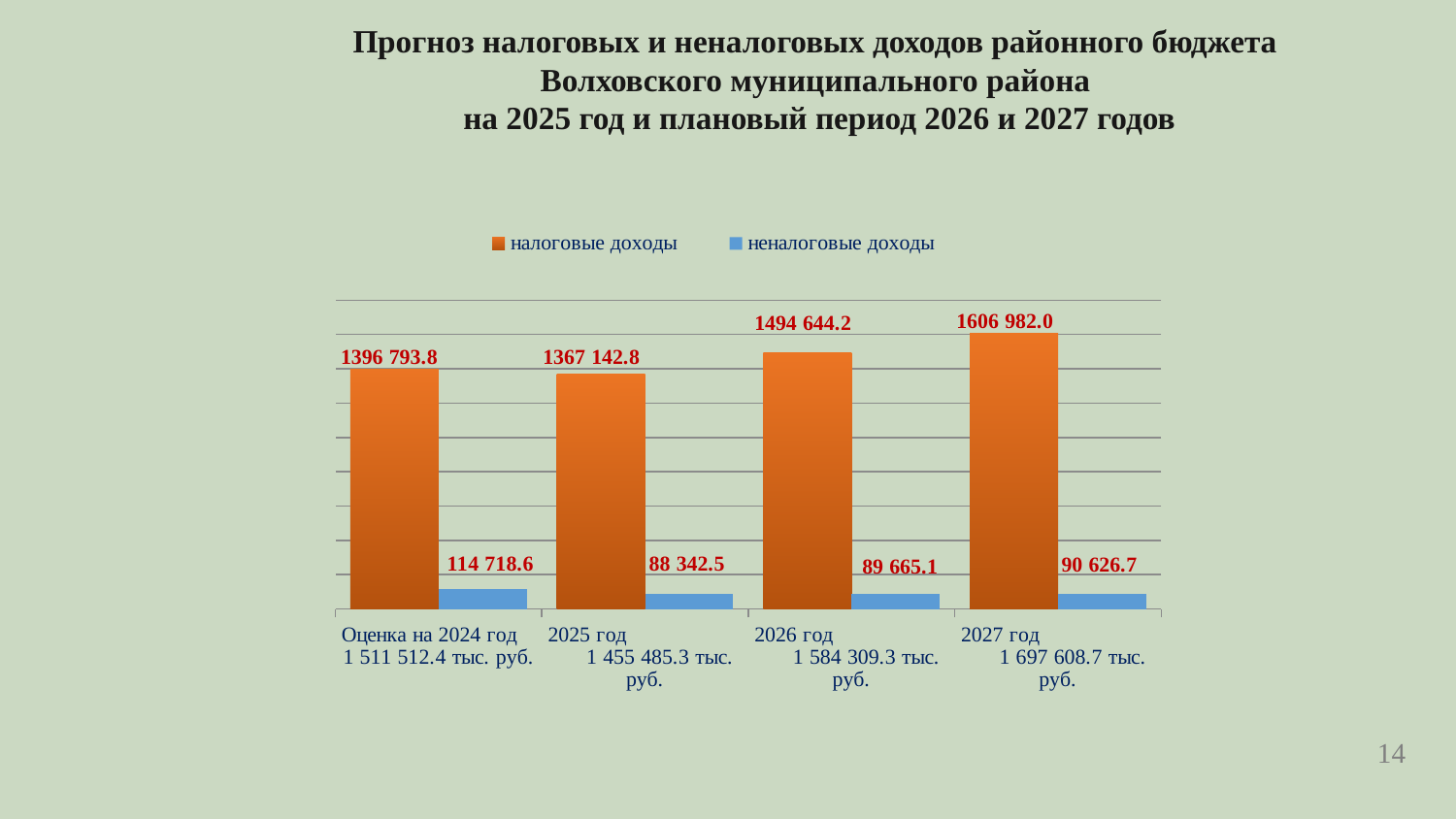
Which category has the lowest value for налоговые доходы? 2025 год What is the value of налоговые доходы for 2027 год? 1606 982.0 What is the value of неналоговые доходы for Оценка на 2024 год? 114 718.6 Which category has the highest value for неналоговые доходы? Оценка на 2024 год How many series does the legend list? 2 What is the difference between налоговые доходы for 2027 год and for Оценка на 2024 год? 210 188.2 Which is larger: неналоговые доходы for 2025 год or for 2027 год? 2027 год What kind of chart is shown on the slide? bar chart What is the value of неналоговые доходы for 2026 год? 89 665.1 What is the value of налоговые доходы for 2025 год? 1367 142.8 Which category has the highest value for налоговые доходы? 2027 год How many categories are shown on the x axis? 4